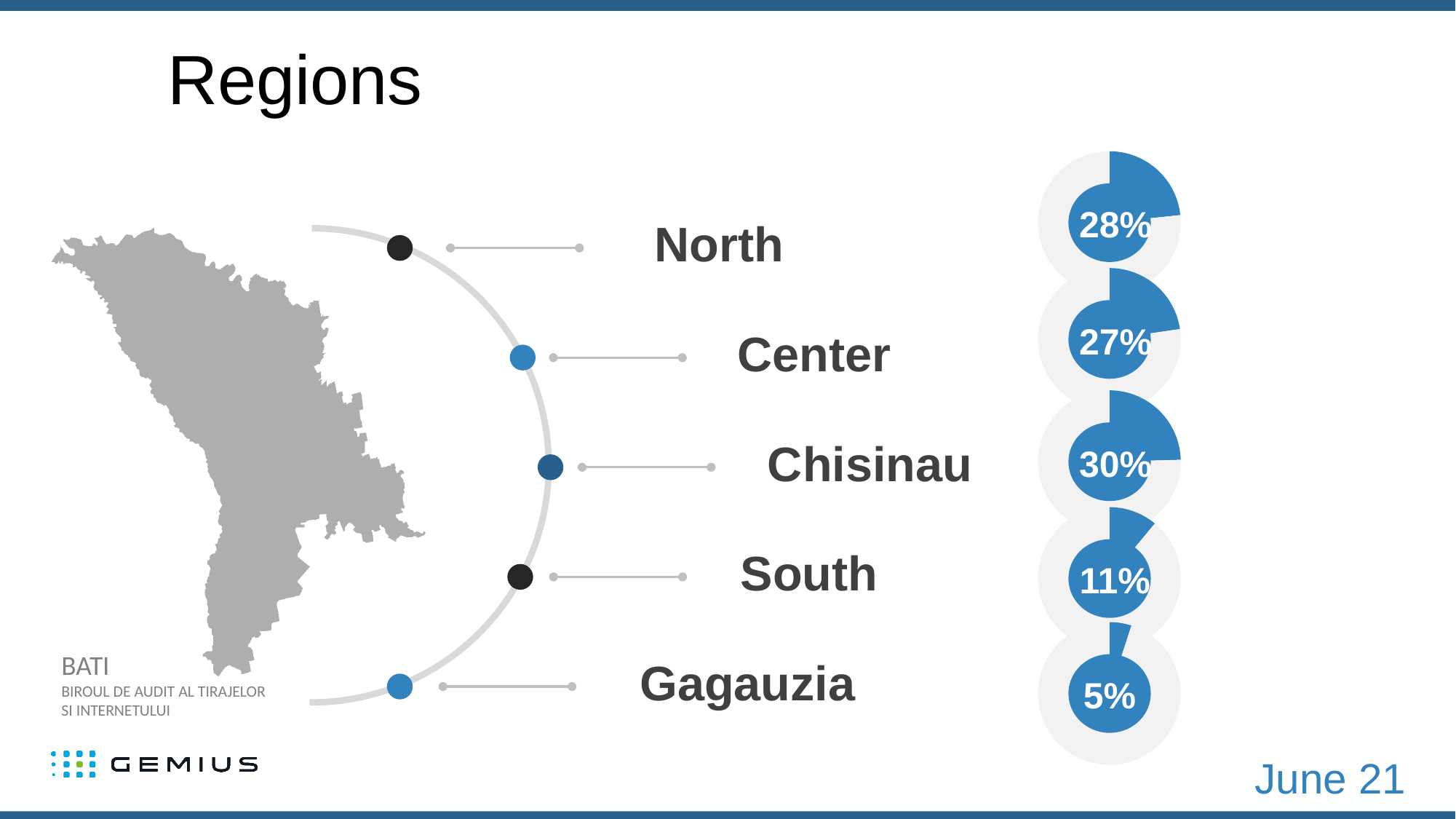
What is the difference between the percentages for North and Gagauzia? 23% Which has a larger percentage, South or Gagauzia? South How many regions are shown with a percentage on the slide? 5 What kind of chart is used to show each region's percentage? Pie chart What percentage is shown for the North region? 28% What percentage is shown for the South region? 11% What is the difference between the percentages for Chisinau and South? 19% What percentage is shown for the Center region? 27% Which region has the lowest percentage? Gagauzia What percentage is shown for Gagauzia? 5% Which region has the highest percentage? Chisinau What percentage is shown for Chisinau? 30%